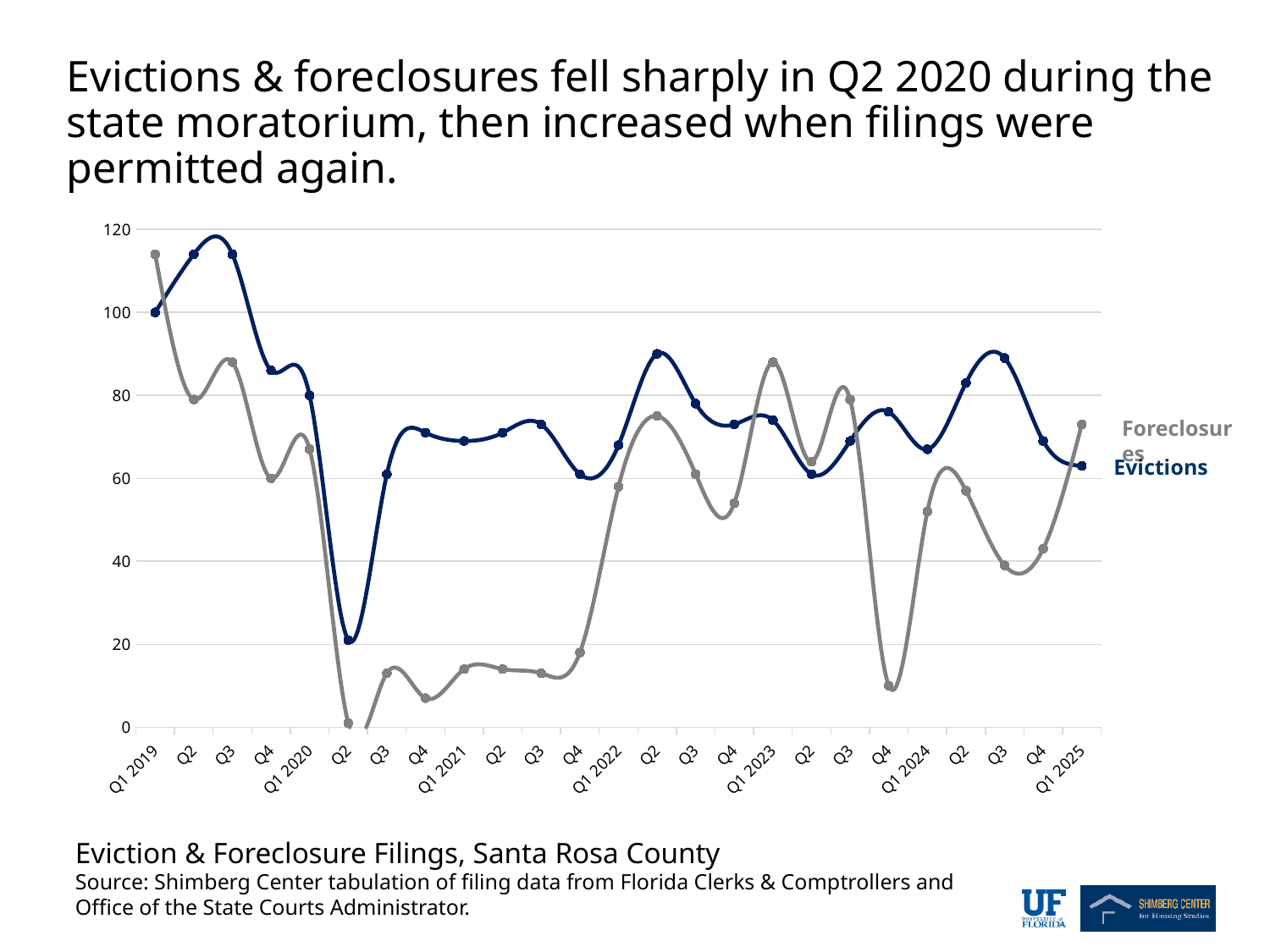
What is the title of the chart given below the plot? Eviction & Foreclosure Filings, Santa Rosa County Is the Evictions value for Q3 2024 greater or less than 80? greater Is the Evictions value for Q2 2020 greater or less than 40? less What kind of chart is shown on the slide? line chart In which quarter is the Evictions series at its lowest? Q2 2020 In which quarter is the Foreclosures series at its highest? Q1 2019 In which quarter is the Foreclosures series at its lowest? Q2 2020 Is the Foreclosures value for Q4 2023 greater or less than 20? less How many quarters are plotted along the x axis, from Q1 2019 to Q1 2025? 25 In Q1 2019, which series has the higher value, Evictions or Foreclosures? Foreclosures In Q4 2023, which series has the higher value, Evictions or Foreclosures? Evictions How many series does the chart show? 2